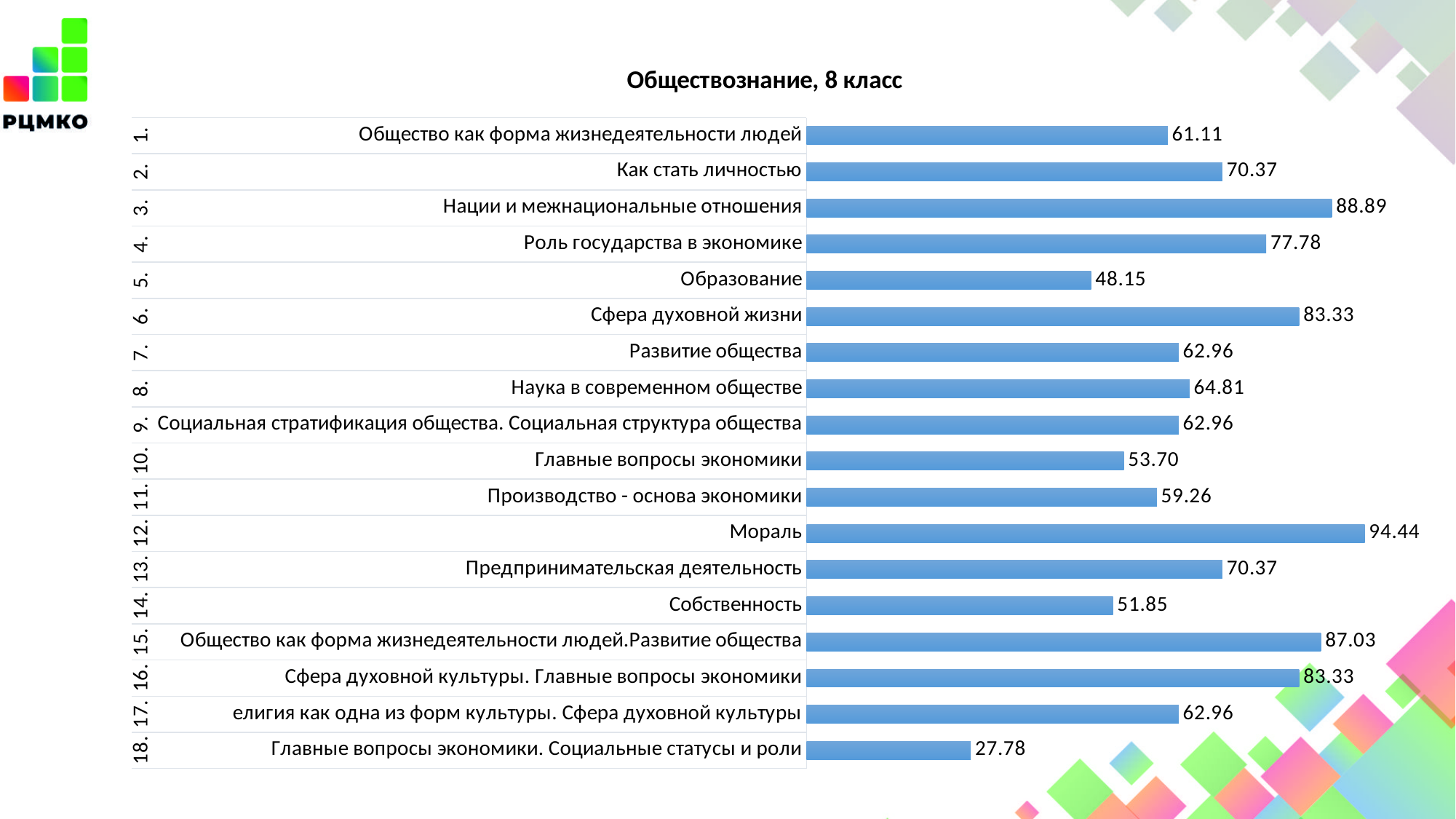
What is the difference between the values for "Мораль" and "Главные вопросы экономики. Социальные статусы и роли"? 66.66 Which category has the lowest value? Главные вопросы экономики. Социальные статусы и роли Which category has the highest value? Мораль What kind of chart is shown on the slide? Bar chart How many categories are shown in the chart? 18 What is the value for "Образование"? 48.15 What is the title of the chart? Обществознание, 8 класс What is the value for "Мораль"? 94.44 What is the difference between the values for "Нации и межнациональные отношения" and "Образование"? 40.74 What is the value for "Нации и межнациональные отношения"? 88.89 Which is larger: the value for "Роль государства в экономике" or for "Как стать личностью"? Роль государства в экономике What is the value for "Главные вопросы экономики. Социальные статусы и роли"? 27.78